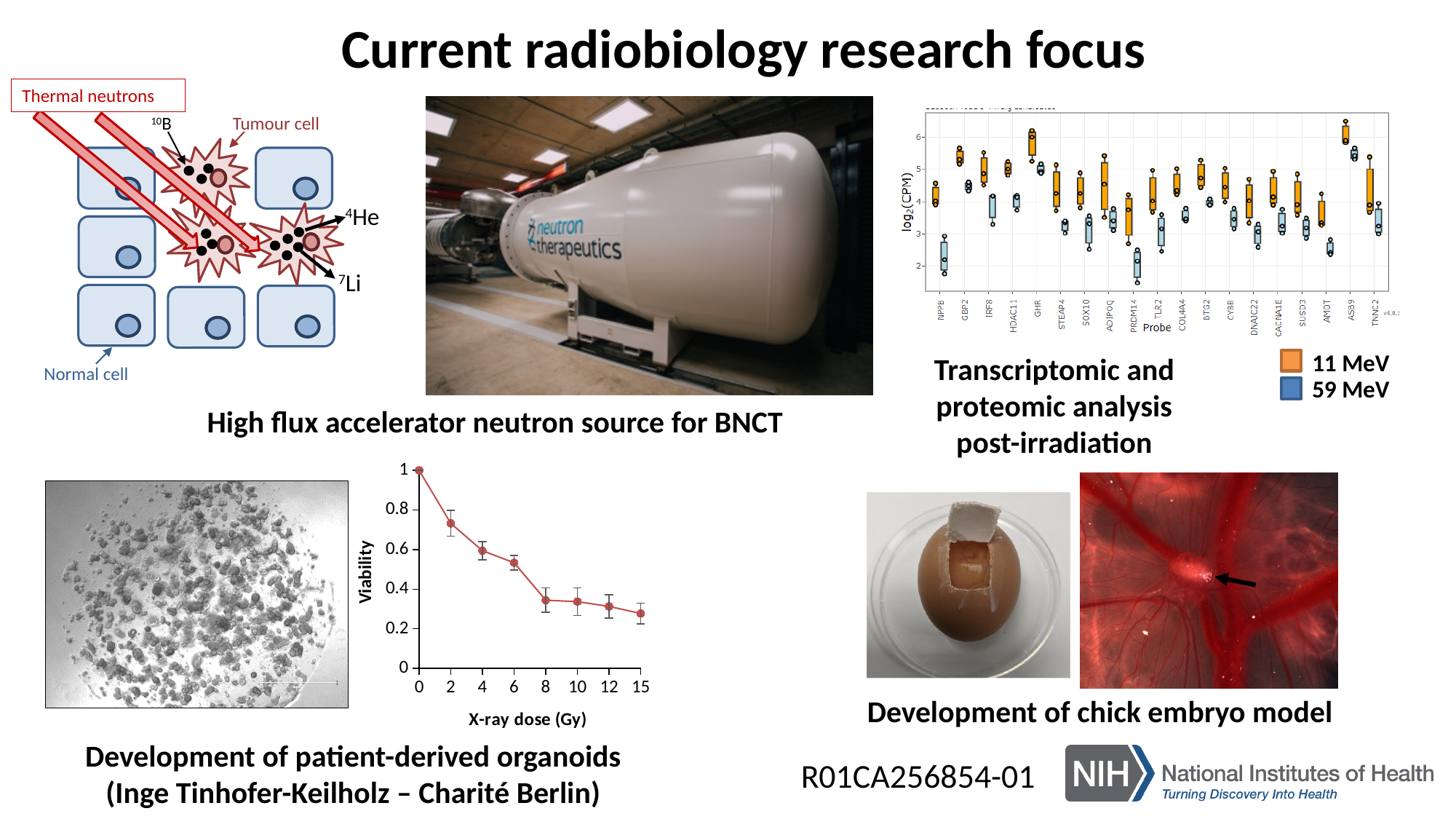
In the transcriptomic box plot at the top right, which probe has the highest 11 MeV value? ASB9 In the transcriptomic box plot at the top right, how many probes are shown on the x axis? 19 In the viability chart, what is the viability at an X-ray dose of 0 Gy? 1 What kind of chart is the viability chart at the bottom left of the slide? line chart In the transcriptomic box plot at the top right, for the probe GHR, which series has the higher value, 11 MeV or 59 MeV? 11 MeV In the viability chart, what is the label of the x axis? X-ray dose (Gy) In the viability chart, is the viability at 2 Gy greater or less than 0.6? greater In the transcriptomic box plot at the top right, how many series does the legend list? 2 In the viability chart, how many data points are plotted? 8 In the viability chart, is the viability at 8 Gy greater or less than 0.4? less In the viability chart, does viability rise or fall as the X-ray dose increases? fall In the viability chart, is the viability at 15 Gy greater or less than 0.2? greater